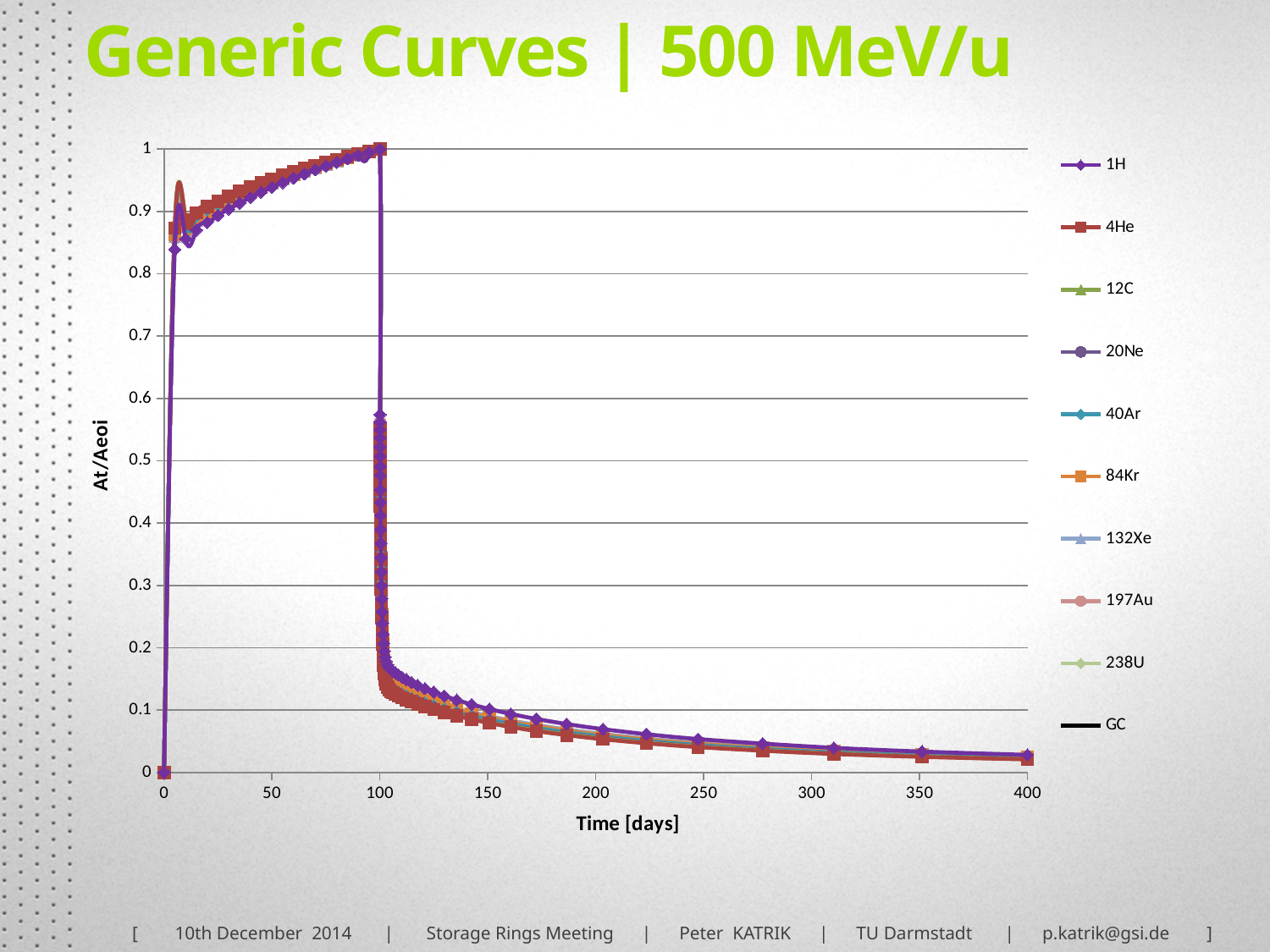
At what time do the curves reach their maximum value? 100 days What is the title of the chart? Generic Curves | 500 MeV/u How many series does the legend list? 10 Is the value of At/Aeoi at 400 days greater or less than 0.1? less Which is larger, the value of At/Aeoi at 50 days or at 150 days? 50 days Is the value of At/Aeoi at 50 days greater or less than 0.9? greater Do the curves rise or fall between 100 days and 400 days? fall Do the curves rise or fall between 20 days and 100 days? rise What kind of chart is shown on the slide? line chart Is the value of At/Aeoi at 300 days greater or less than 0.1? less What is the maximum value of At/Aeoi reached by the curves? 1 What is the label of the x axis? Time [days]